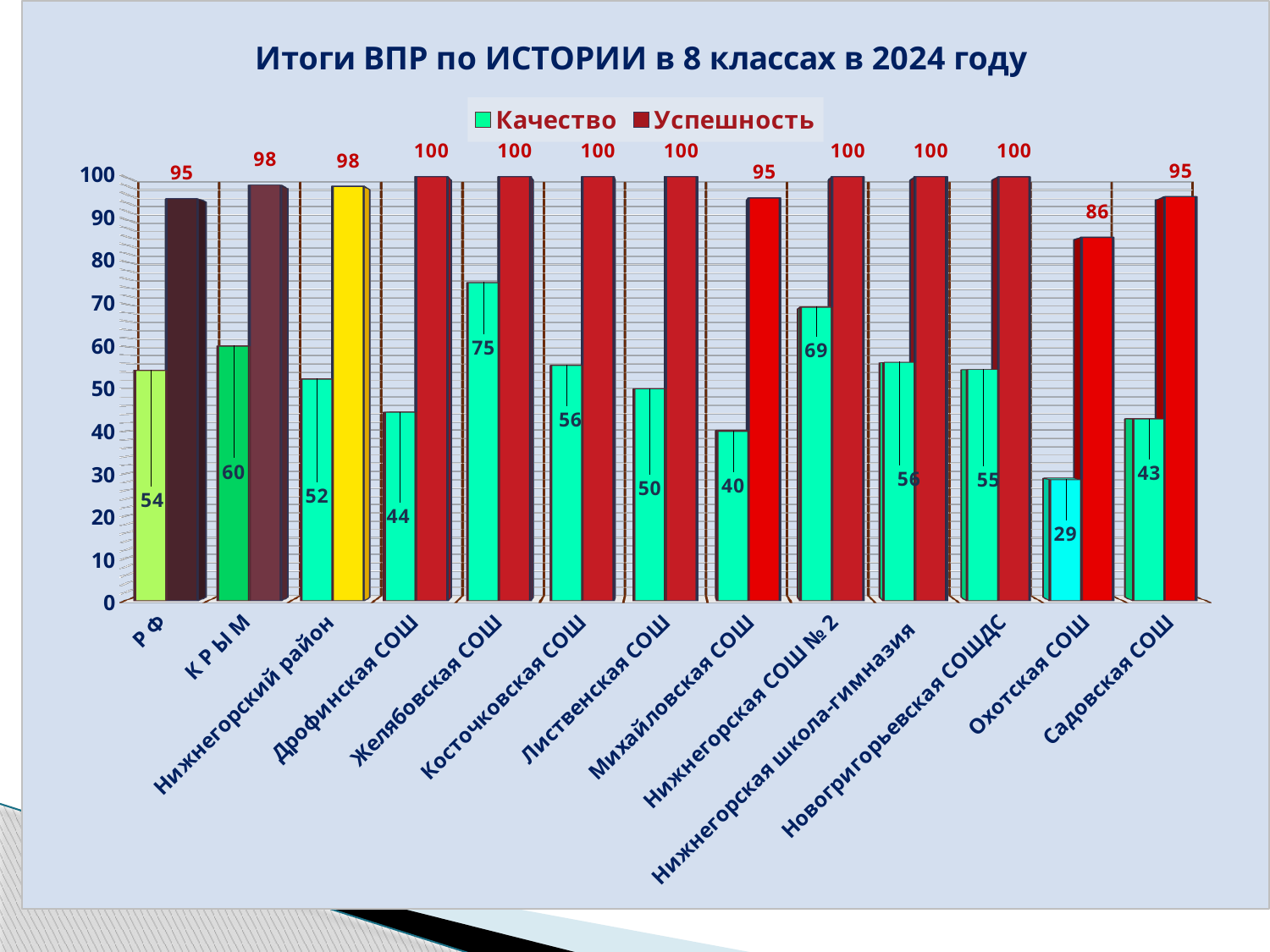
How many series does the legend list? 2 What is the difference between the Качество values for Желябовская СОШ and Охотская СОШ? 46 What is the Качество value for Желябовская СОШ? 75 How many categories are shown on the x axis? 13 Which category has the lowest Успешность value? Охотская СОШ What kind of chart is shown on the slide? bar chart Which has a higher Качество value, Нижнегорская СОШ № 2 or К Р Ы М? Нижнегорская СОШ № 2 For РФ, what is the difference between the Успешность and Качество values? 41 What is the Успешность value for Охотская СОШ? 86 Which category has the highest Качество value? Желябовская СОШ Which category has the lowest Качество value? Охотская СОШ What is the Качество value for Нижнегорский район? 52